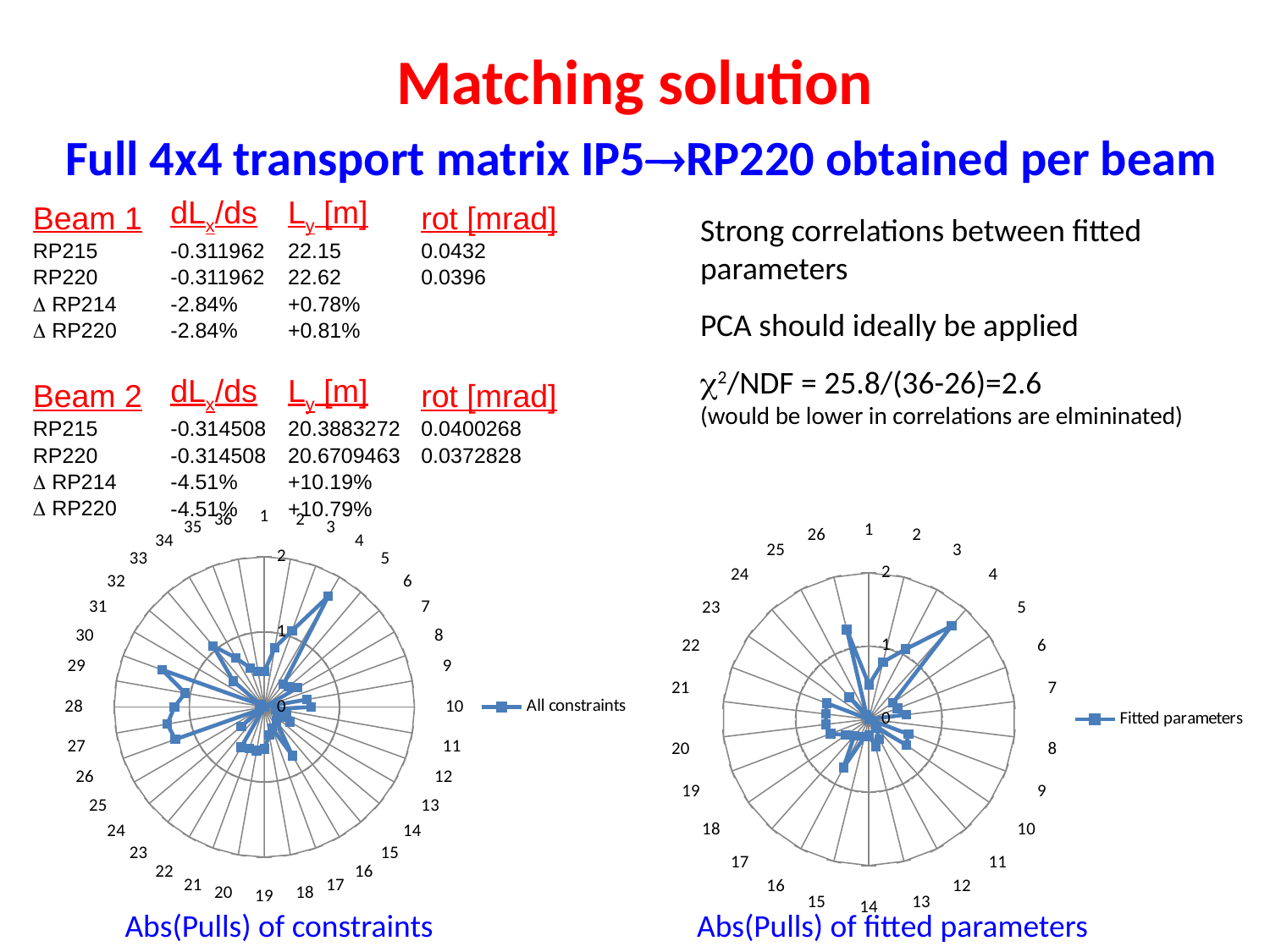
What kind of chart is the right chart, 'Abs(Pulls) of fitted parameters'? radar chart How many categories are plotted around the left chart, 'Abs(Pulls) of constraints'? 36 What kind of chart is the left chart, 'Abs(Pulls) of constraints'? radar chart What is the name of the series shown in the legend of the left chart, 'Abs(Pulls) of constraints'? All constraints How many series does the legend of the left chart, 'Abs(Pulls) of constraints', list? 1 In the right chart, 'Abs(Pulls) of fitted parameters', is the value for category 14 greater or less than 1? less In the right chart, 'Abs(Pulls) of fitted parameters', which category has the highest value? 4 How many categories are plotted around the right chart, 'Abs(Pulls) of fitted parameters'? 26 In the right chart, 'Abs(Pulls) of fitted parameters', is the value for category 4 greater or less than 1? greater How many series does the legend of the right chart, 'Abs(Pulls) of fitted parameters', list? 1 What is the name of the series shown in the legend of the right chart, 'Abs(Pulls) of fitted parameters'? Fitted parameters In the left chart, 'Abs(Pulls) of constraints', is the value for category 19 greater or less than 1? less